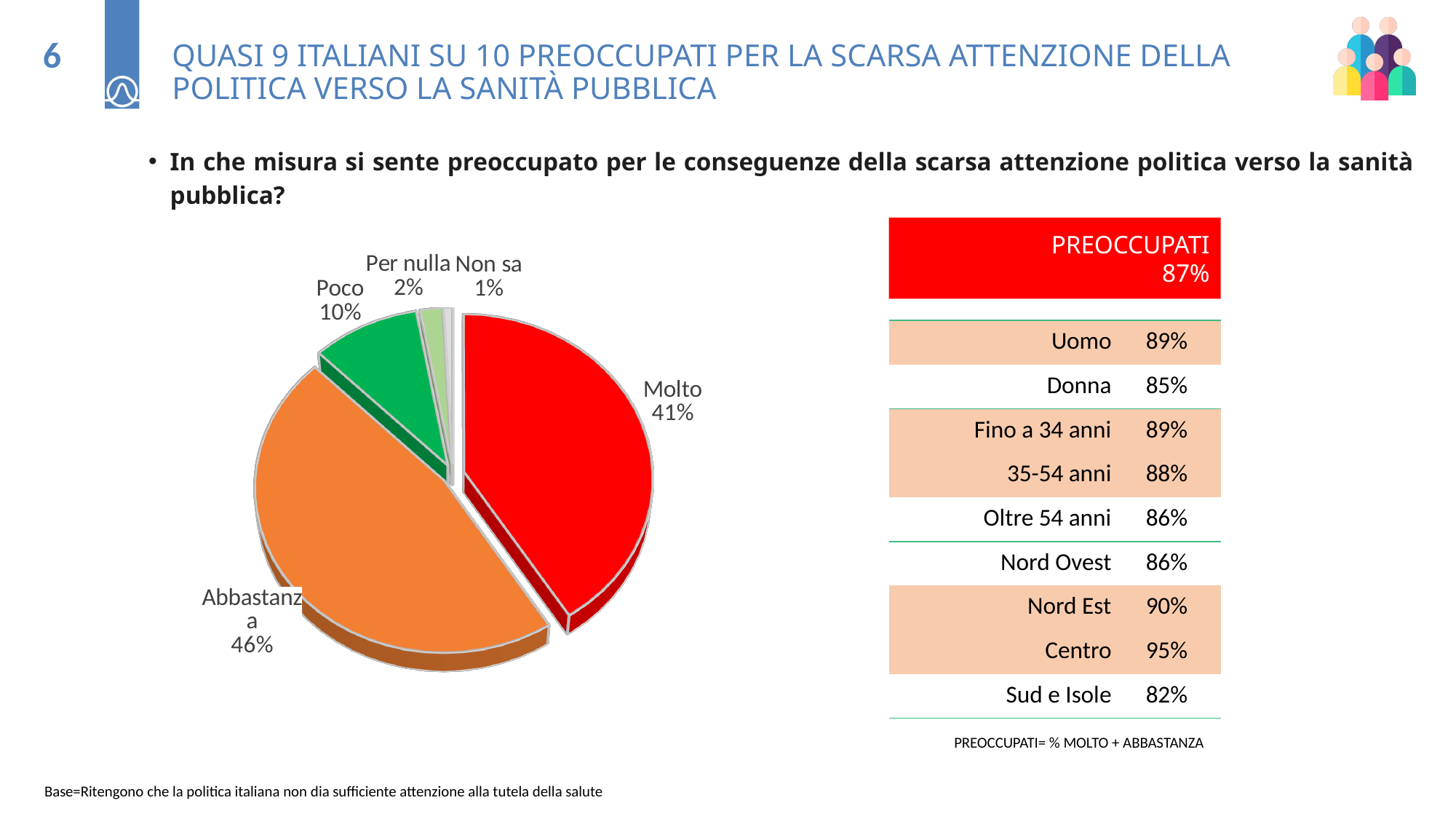
What percentage of the pie chart is the "Per nulla" slice? 2% Which slice is larger in the pie chart, "Poco" or "Per nulla"? Poco What percentage of the pie chart is the "Poco" slice? 10% What type of chart is shown on the slide? Pie chart What percentage of the pie chart is the "Non sa" slice? 1% What colour is the "Molto" slice in the pie chart? Red Which slice of the pie chart is the largest? Abbastanza What percentage of the pie chart is the "Abbastanza" slice? 46% What is the difference in percentage points between the "Abbastanza" and "Molto" slices? 5 What percentage of the pie chart is the "Molto" slice? 41% Which slice of the pie chart is the smallest? Non sa How many slices does the pie chart have? 5